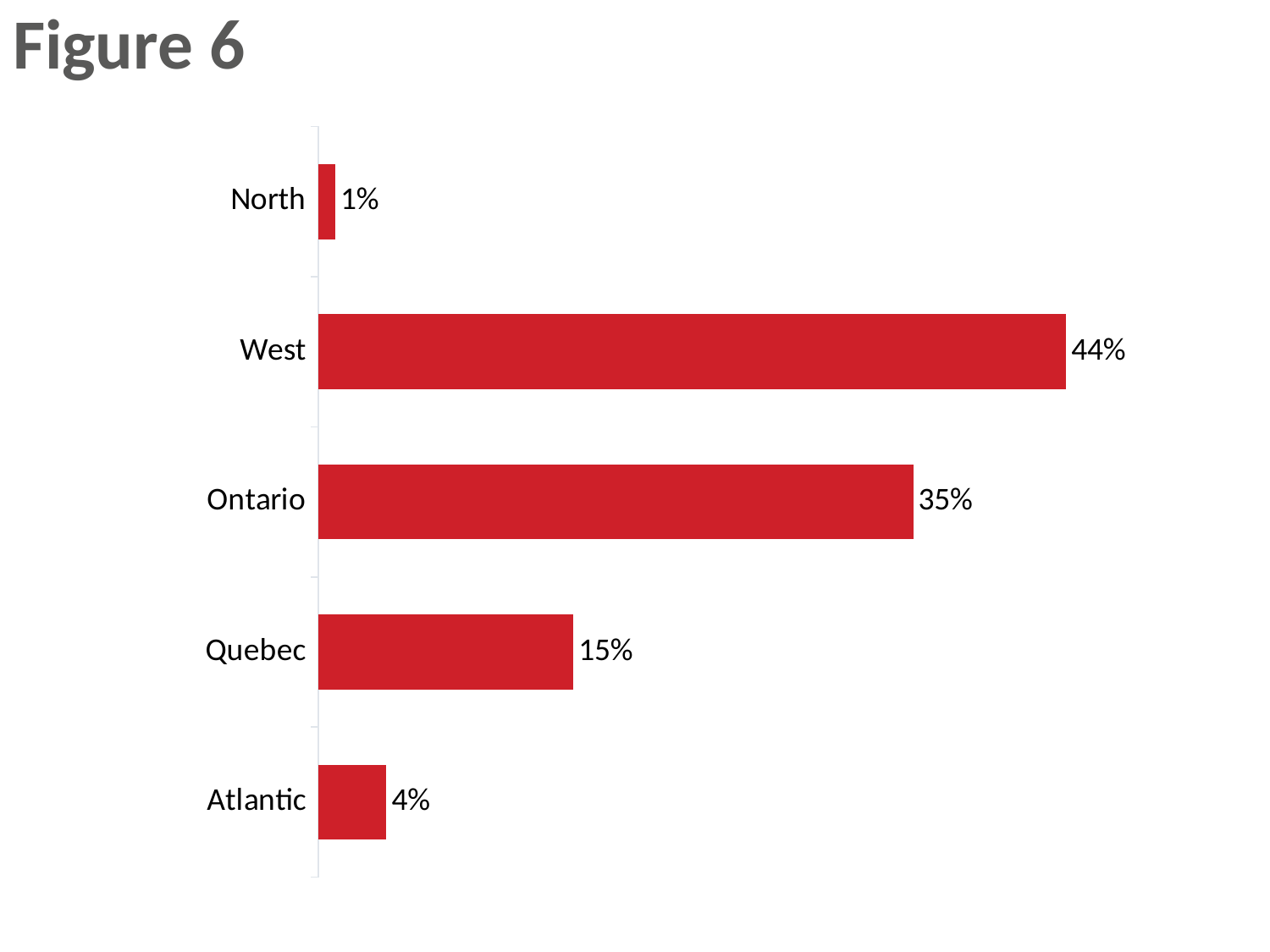
What is the difference between the values for West and Ontario? 9% What is the value for Quebec? 15% What is the value for West? 44% What is the value for Ontario? 35% What is the value for North? 1% What is the difference between the values for Quebec and Atlantic? 11% Which is larger, the value for Quebec or the value for Atlantic? Quebec How many regions are shown in the chart? 5 Which region has the highest value? West What is the value for Atlantic? 4% What kind of chart is shown on the slide? Bar chart Which region has the lowest value? North